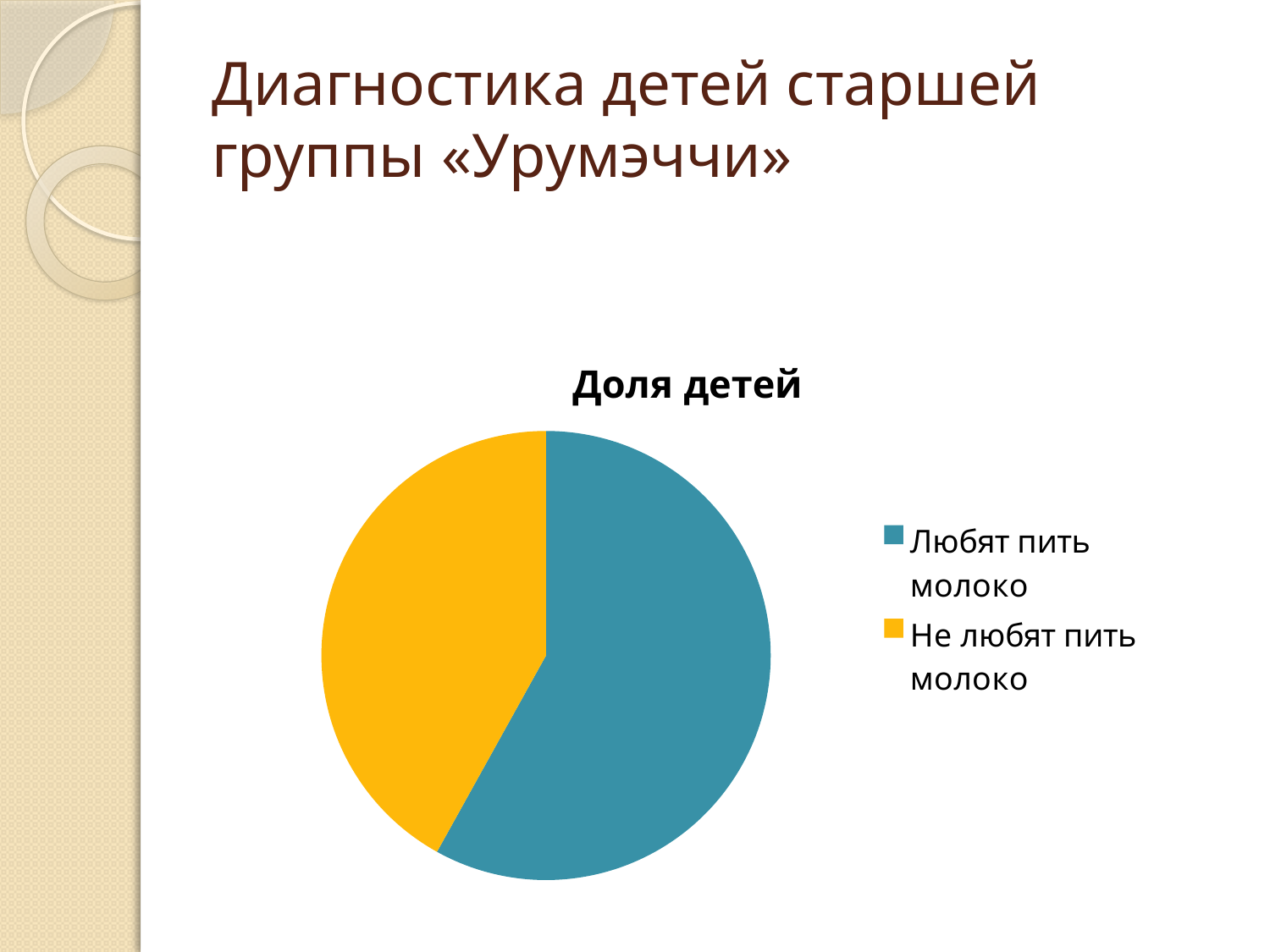
What colour is the slice for Не любят пить молоко? Yellow How many entries does the legend list? 2 What kind of chart is shown on the slide? Pie chart What is the title of the chart? Доля детей Is the share for Не любят пить молоко greater or less than half of the pie? less Which slice is larger: Любят пить молоко or Не любят пить молоко? Любят пить молоко How many slices does the pie chart have? 2 Which category has the largest slice of the pie? Любят пить молоко Which category has the smallest slice of the pie? Не любят пить молоко Is the share for Любят пить молоко greater or less than half of the pie? greater